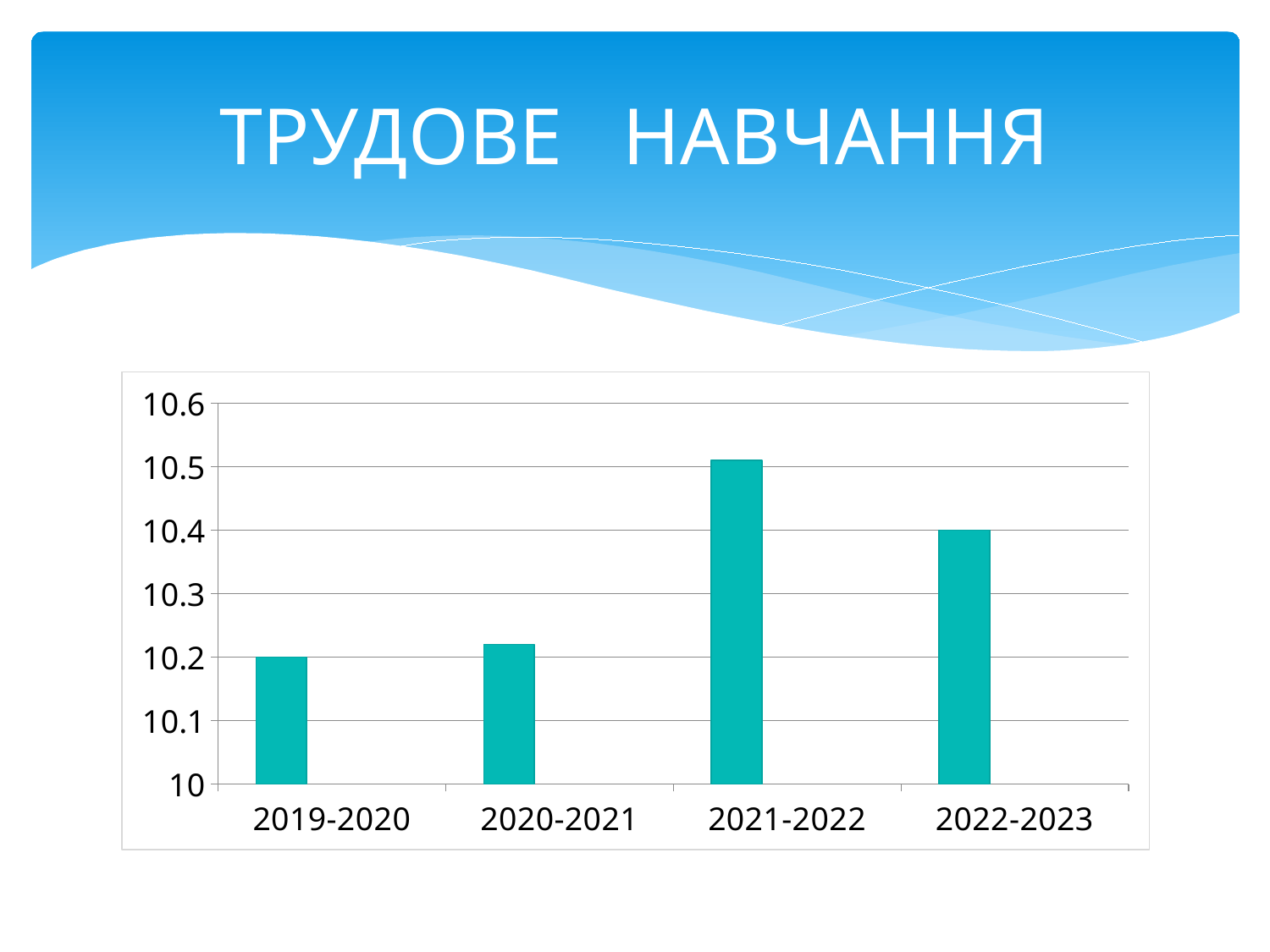
Is the value for 2020-2021 greater or less than 10.3? less What is the difference between the values for 2022-2023 and 2019-2020? 0.2 Do the values rise or fall from 2019-2020 to 2021-2022? rise Is the value for 2021-2022 greater or less than 10.4? greater What kind of chart is shown on the slide? bar chart What is the title shown at the top of the slide? ТРУДОВЕ НАВЧАННЯ What is the value for 2019-2020? 10.2 Which is larger, the value for 2019-2020 or the value for 2022-2023? 2022-2023 Which is larger, the value for 2021-2022 or the value for 2022-2023? 2021-2022 What is the value for 2022-2023? 10.4 Which school year has the highest value? 2021-2022 How many school years are shown on the x axis? 4